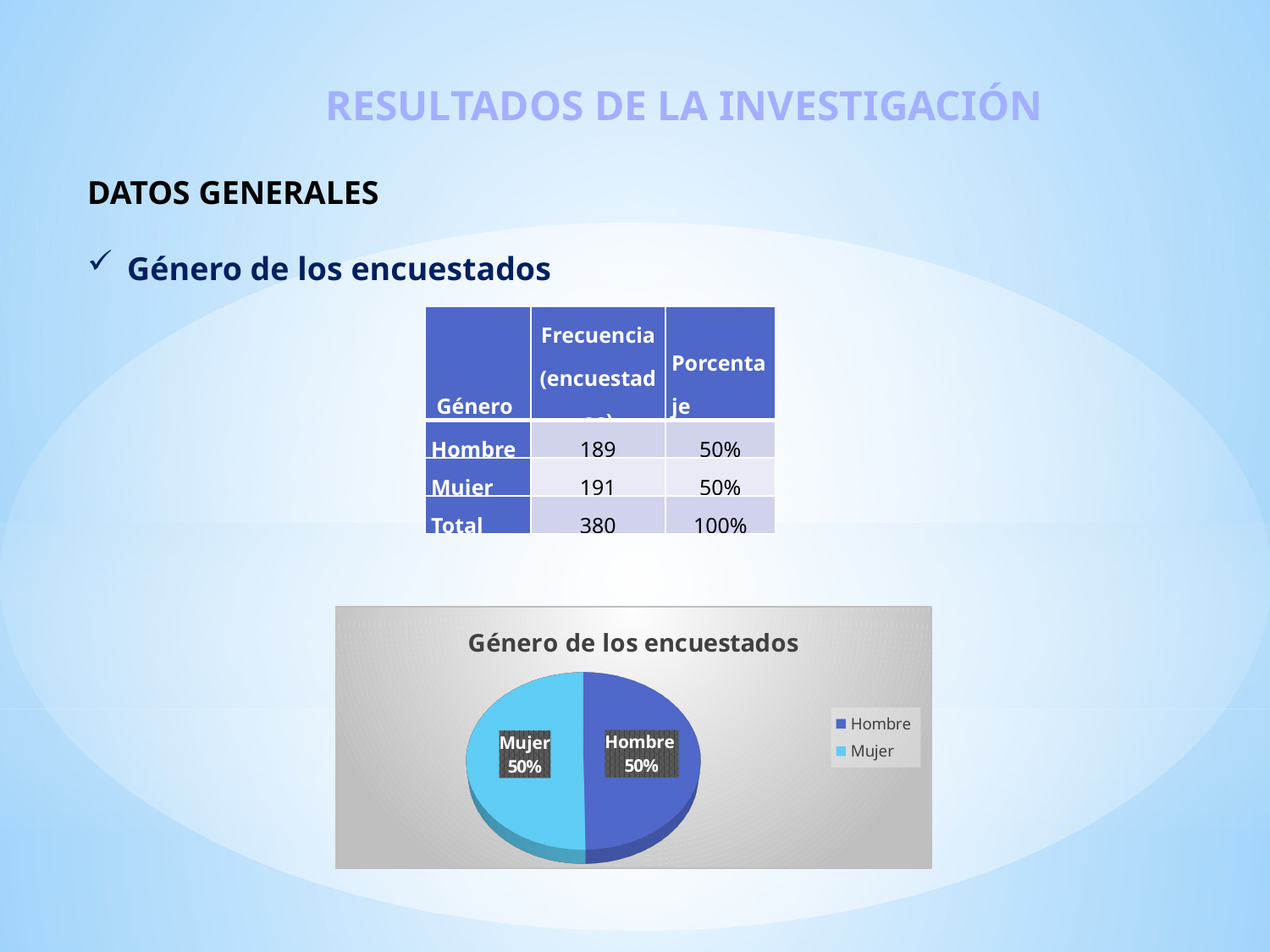
How many slices does the pie chart have? 2 What share of the pie does the Hombre slice represent? 50% What is the title of the chart? Género de los encuestados What is the difference between the Hombre and Mujer shares in the pie chart? 0% Which categories are listed in the chart legend? Hombre and Mujer Is the share for Mujer greater or less than 60%? less What is the combined share of the Hombre and Mujer slices? 100% What type of chart is shown on the slide? pie chart What share of the pie does the Mujer slice represent? 50% How many entries does the chart legend list? 2 Is the share for Hombre greater or less than 40%? greater